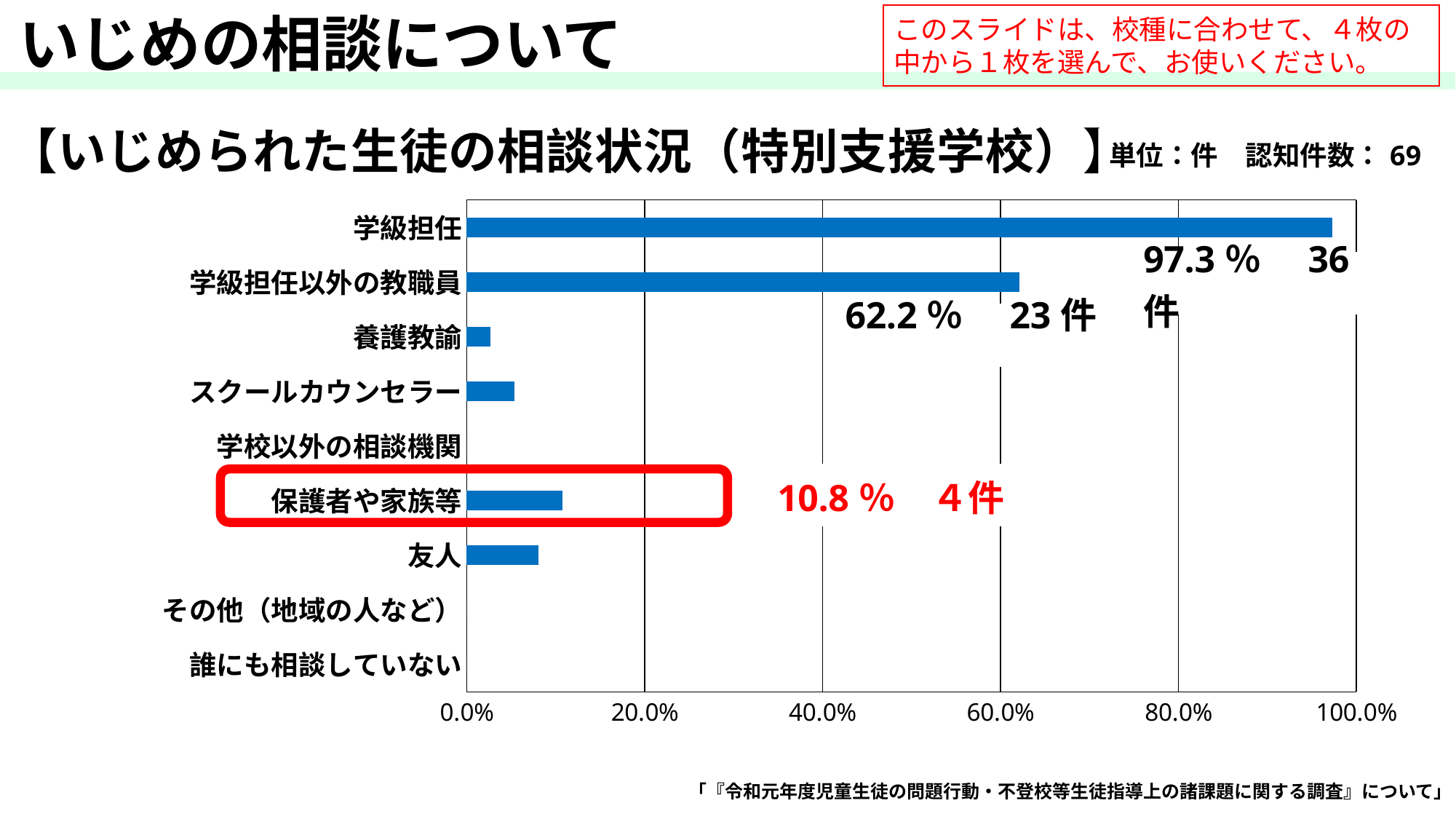
How many categories are listed on the vertical axis of the chart? 9 What is the difference in percentage between 学級担任 and 学級担任以外の教職員? 35.1 percentage points Is the value for 友人 greater or less than 20.0%? less What percentage is shown for 学級担任以外の教職員? 62.2% How many more cases does 学級担任 have than 学級担任以外の教職員? 13件 What percentage is shown for 保護者や家族等? 10.8% What kind of chart is shown on the slide? bar chart Which is larger, the value for スクールカウンセラー or the value for 養護教諭? スクールカウンセラー Which category has the highest value in the chart? 学級担任 How many cases (件) are labelled for 学級担任? 36件 How many cases (件) are labelled for 保護者や家族等? 4件 What percentage is shown for 学級担任 in the chart? 97.3%